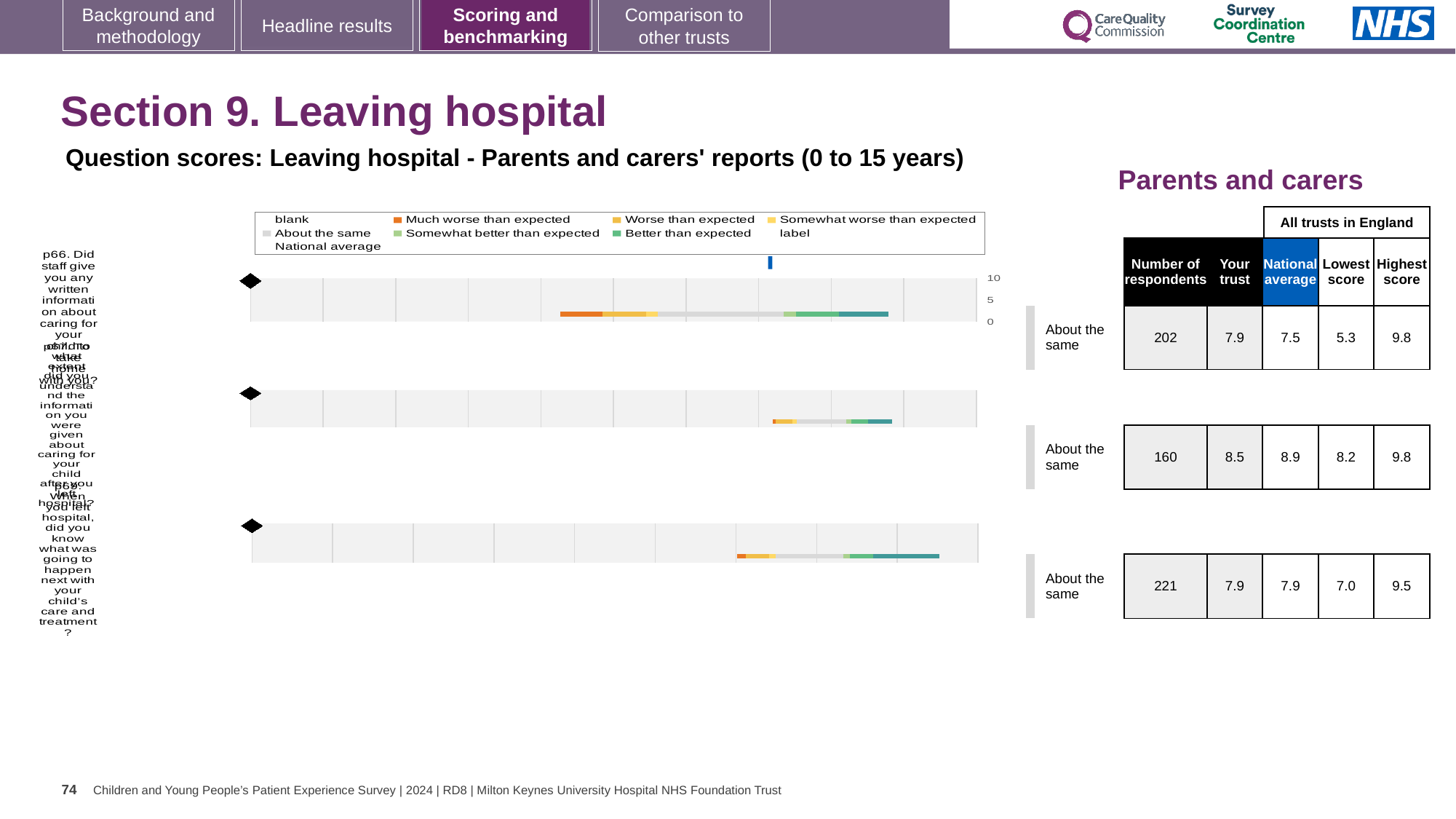
What colour represents 'Much worse than expected' in the legend? orange What does the blue vertical marker in the legend represent? National average What is the maximum value shown on the score axis of the top chart? 10 For the middle chart, which is larger: the 'Your trust' score or the national average? National average For the top chart, what is the difference between the 'Your trust' score and the national average? 0.4 How many benchmark bar charts are shown on the slide? 3 Which chart (top, middle or bottom) has the highest number of respondents in its table? bottom What kind of chart is used to show the question scores on this slide? bar chart In the table beside the middle chart, what is the 'Your trust' score? 8.5 How many entries does the legend above the charts list? 9 In the table beside the top chart, what is the number of respondents? 202 In the table beside the bottom chart, what is the lowest score among all trusts in England? 7.0